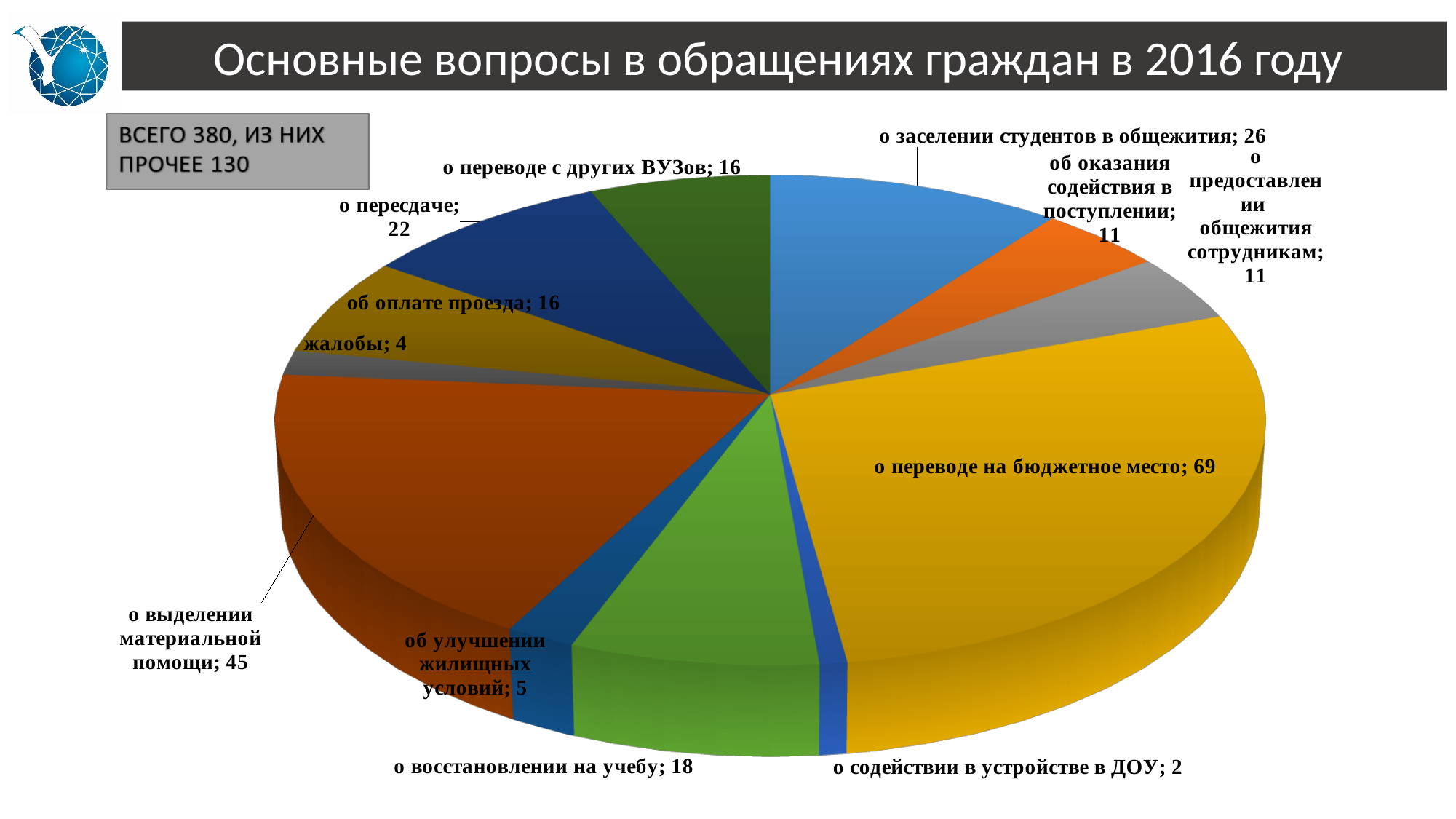
What is the value for 'жалобы'? 4 What kind of chart is shown on the slide? pie chart Which category has the highest value in the pie chart? о переводе на бюджетное место What is the difference between the values for 'о переводе на бюджетное место' and 'о выделении материальной помощи'? 24 How many categories (slices) does the pie chart have? 12 What is the value for 'о выделении материальной помощи'? 45 Which is larger: the value for 'о восстановлении на учебу' or the value for 'об оплате проезда'? о восстановлении на учебу What is the title of the slide? Основные вопросы в обращениях граждан в 2016 году What is the value for 'о пересдаче'? 22 Which category has the lowest value in the pie chart? о содействии в устройстве в ДОУ What is the value for 'о заселении студентов в общежития'? 26 According to the text box on the slide, what is the total number of appeals (ВСЕГО)? 380